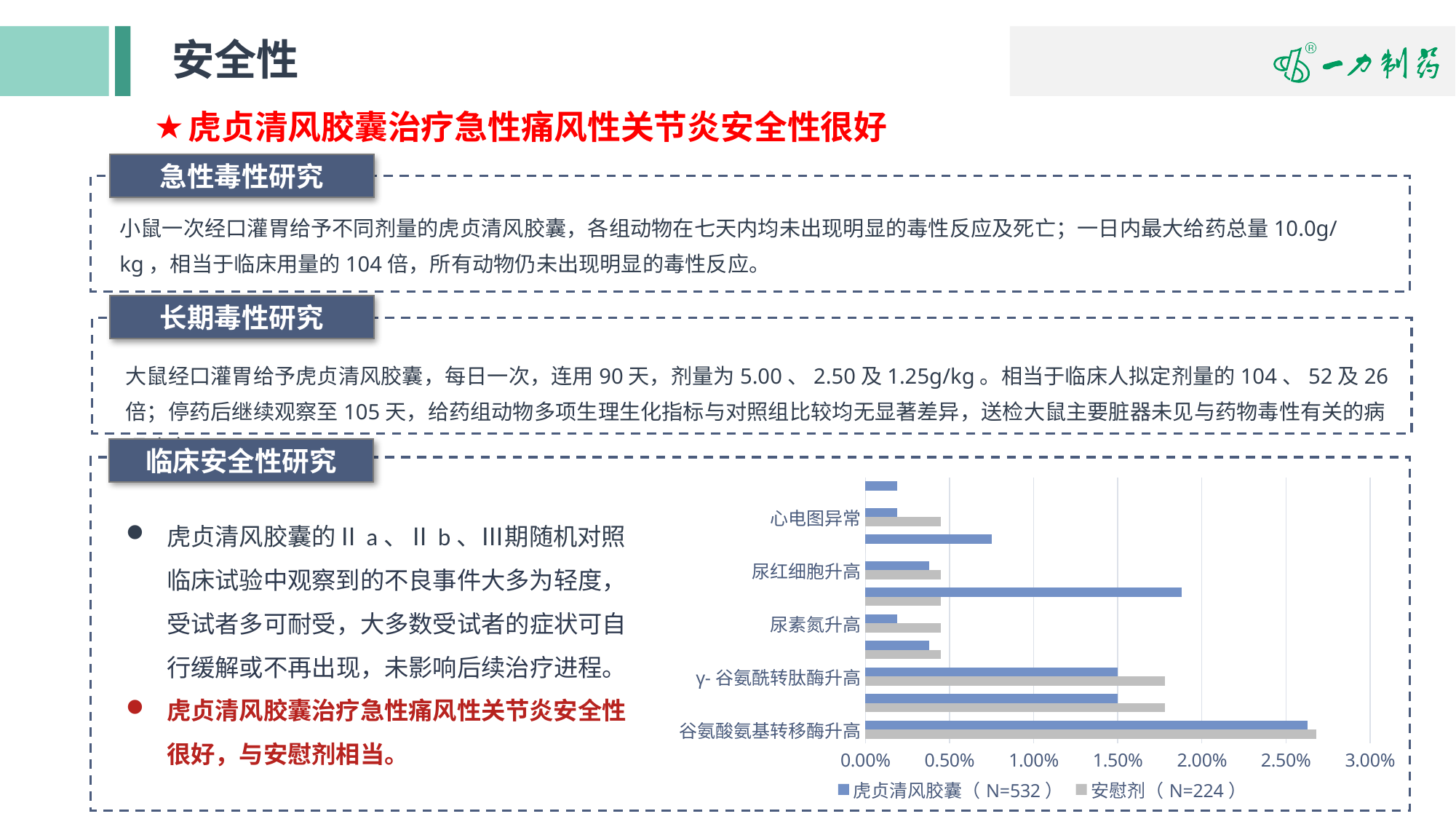
Is the 安慰剂（N=224） value for 谷氨酸氨基转移酶升高 greater or less than 2.50%? greater Is the 虎贞清风胶囊（N=532） value for 谷氨酸氨基转移酶升高 greater or less than 2.50%? greater For γ-谷氨酰转肽酶升高, which series has the larger value, 虎贞清风胶囊（N=532） or 安慰剂（N=224）? 安慰剂（N=224） For 尿素氮升高, which series has the larger value, 虎贞清风胶囊（N=532） or 安慰剂（N=224）? 安慰剂（N=224） How many series does the chart legend list? 2 Which colour represents the 安慰剂（N=224） series in the chart? gray What are the two series named in the chart legend? 虎贞清风胶囊（N=532）and 安慰剂（N=224） What kind of chart is shown on the slide? bar chart Is the 虎贞清风胶囊（N=532） value for 心电图异常 greater or less than 0.50%? less Which labelled category has the highest value for 虎贞清风胶囊（N=532）? 谷氨酸氨基转移酶升高